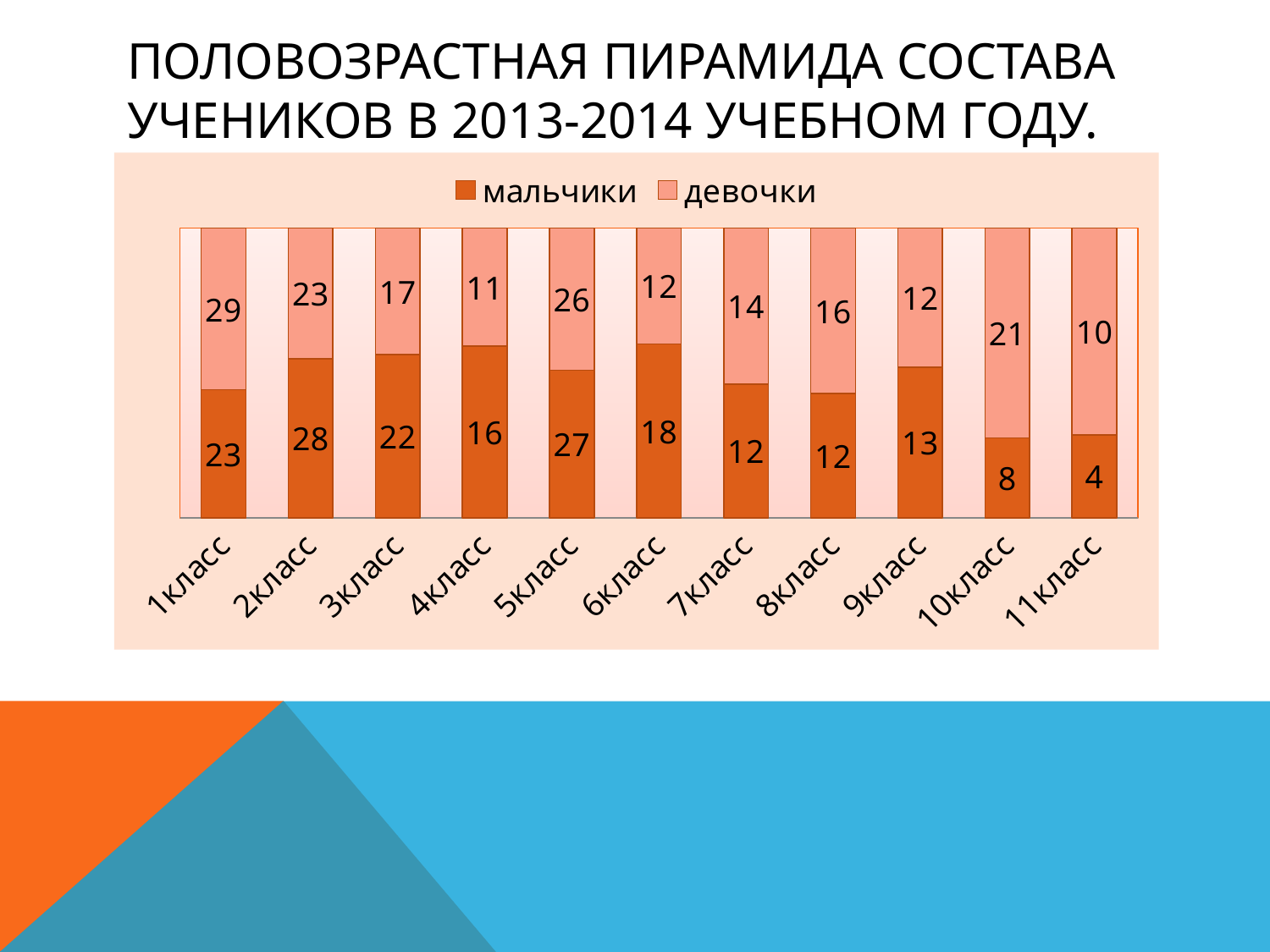
How many boys (мальчики) are in 5класс? 27 Which is larger in 8класс: the number of boys or the number of girls? girls (девочки) How many girls (девочки) are in 10класс? 21 What is the difference between the number of girls and the number of boys in 1класс? 6 What are the two series named in the legend? мальчики and девочки How many boys (мальчики) are in 1класс? 23 What kind of chart is shown on the slide? stacked bar chart Which class has the highest number of boys (мальчики)? 2класс How many series does the legend list? 2 What is the total number of students (boys plus girls) in 11класс? 14 Which class has the lowest number of girls (девочки)? 11класс How many classes are shown on the x axis? 11